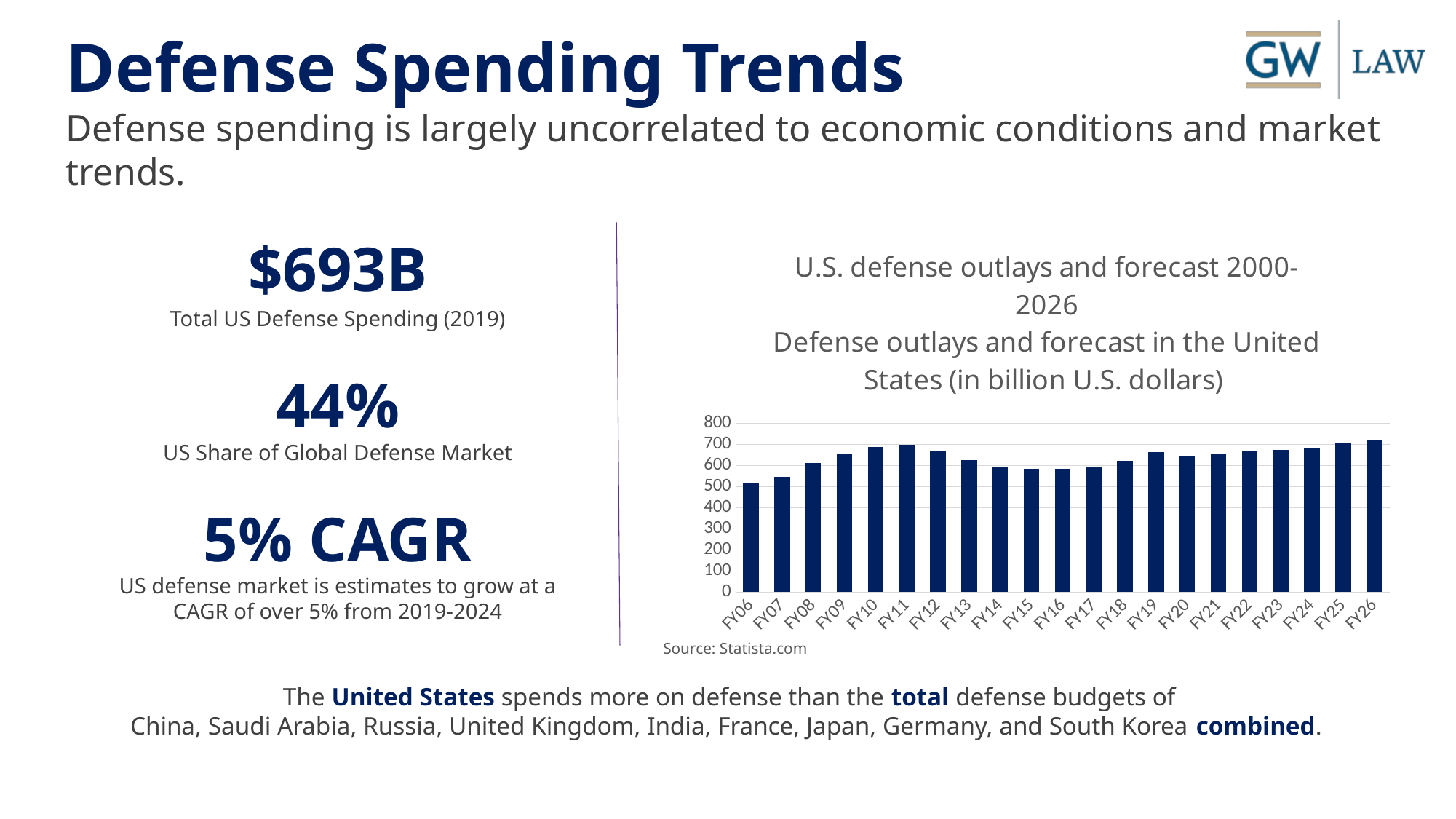
Do the defense outlays rise or fall from FY11 to FY15? Fall Which is larger, the value for FY10 or the value for FY06? FY10 What kind of chart is shown on the slide? Bar chart Is the value for FY06 greater or less than 600? less What source is cited below the chart? Statista.com How many fiscal years are plotted in the defense outlays chart? 21 Is the value for FY11 greater or less than 600? greater Is the value for FY15 greater or less than 600? less Which is larger, the value for FY13 or the value for FY16? FY13 Which fiscal year has the lowest defense outlays in the chart? FY06 Which fiscal year has the highest defense outlays in the chart? FY26